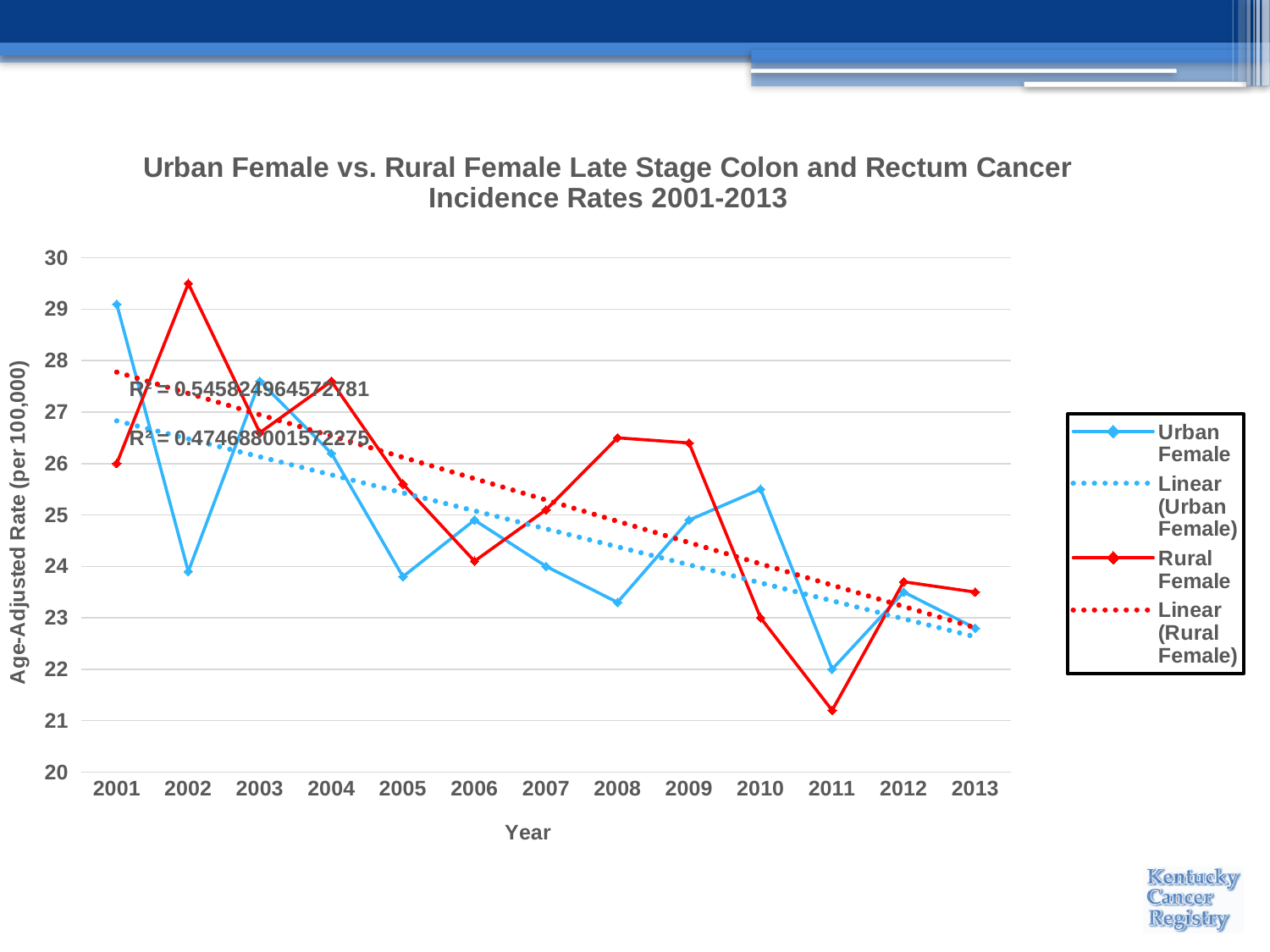
What is the title of the y axis? Age-Adjusted Rate (per 100,000) In which year is the Rural Female rate highest? 2002 In which year is the Urban Female rate highest? 2001 Is the Urban Female value for 2001 greater or less than 28? greater What kind of chart is shown on the slide? line chart In which year is the Urban Female rate lowest? 2011 Is the Rural Female value for 2011 greater or less than 22? less In 2002, which is larger, the Urban Female rate or the Rural Female rate? Rural Female How many years are plotted along the x axis? 13 How many entries does the legend list? 4 In which year is the Rural Female rate lowest? 2011 Overall, do the Urban Female and Rural Female rates rise or fall from 2001 to 2013? fall